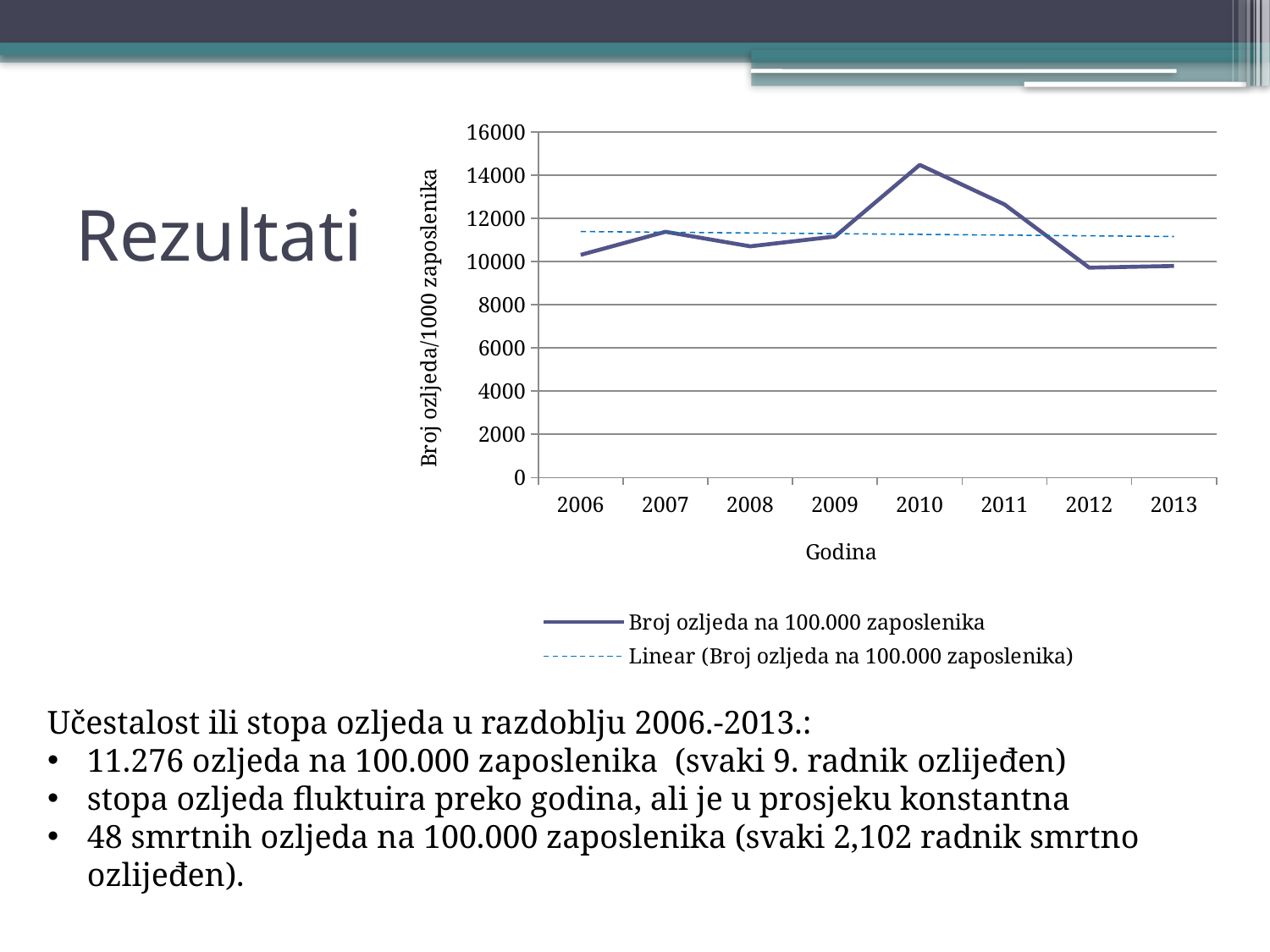
Does the line rise or fall from 2010 to 2012? fall In which year does the line 'Broj ozljeda na 100.000 zaposlenika' reach its highest value? 2010 What is the title of the x axis of the chart? Godina Is the value for 2010 greater or less than 14000? greater Is the value for 2011 greater or less than 12000? greater Is the value for 2006 greater or less than 12000? less How many years are plotted along the x axis of the chart? 8 Which year has the larger value, 2010 or 2006? 2010 What kind of chart is shown on the slide? line chart What is the title of the y axis of the chart? Broj ozljeda/1000 zaposlenika How many entries does the chart's legend list? 2